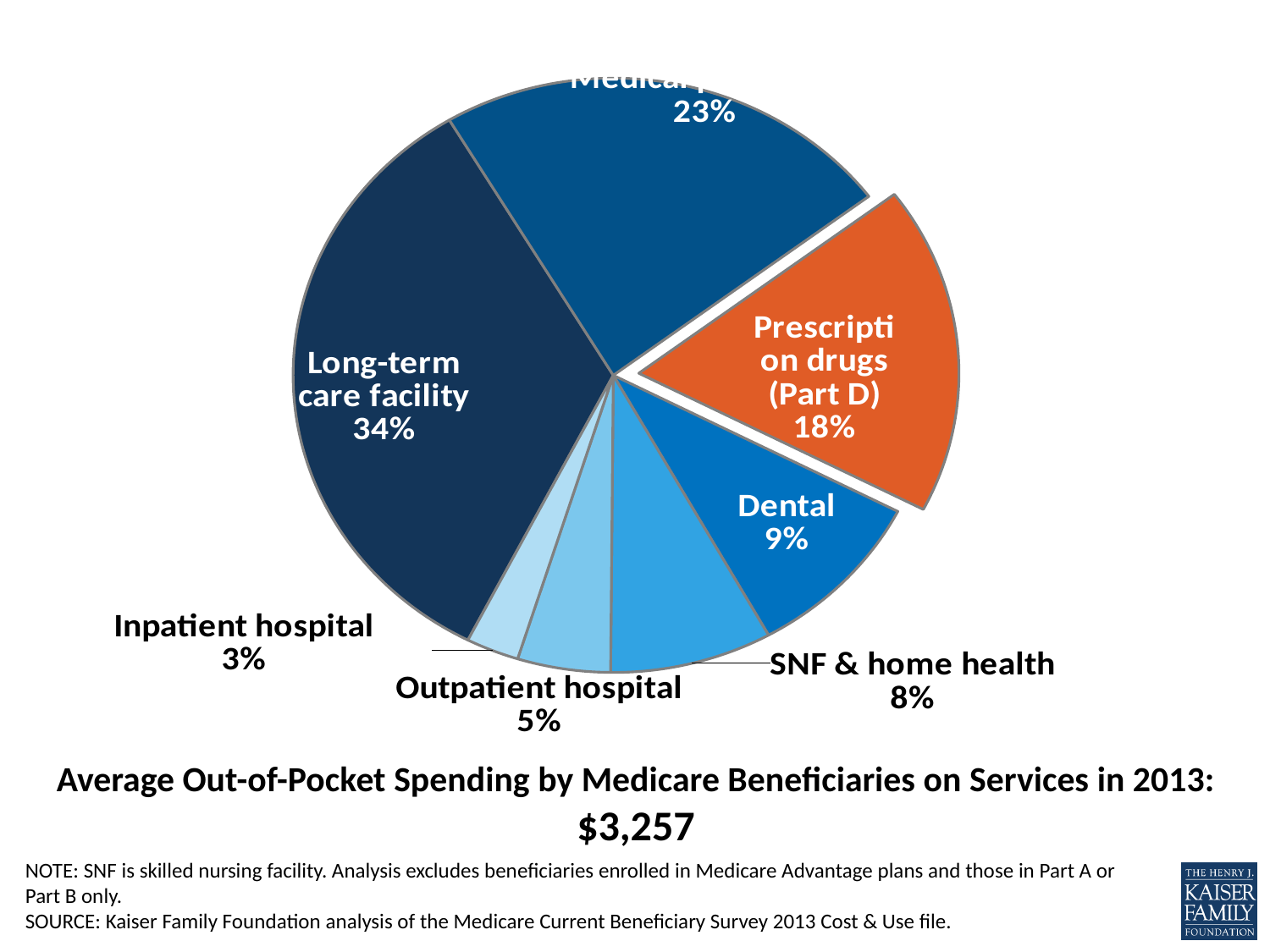
What percentage of the pie is Prescription drugs (Part D)? 18% What is the total average out-of-pocket spending amount stated in the chart title? $3,257 What percentage is shown for Outpatient hospital? 5% What is the value shown for SNF & home health? 8% Which category has the largest share of the pie? Long-term care facility Which category has the smallest share of the pie? Inpatient hospital What share of out-of-pocket spending goes to Long-term care facility? 34% How many slices does the pie chart have? 7 Which is larger, the share for Dental or the share for SNF & home health? Dental How many percentage points larger is the Long-term care facility share than the Prescription drugs (Part D) share? 16 percentage points What share does Dental account for? 9% What share is shown for Inpatient hospital? 3%